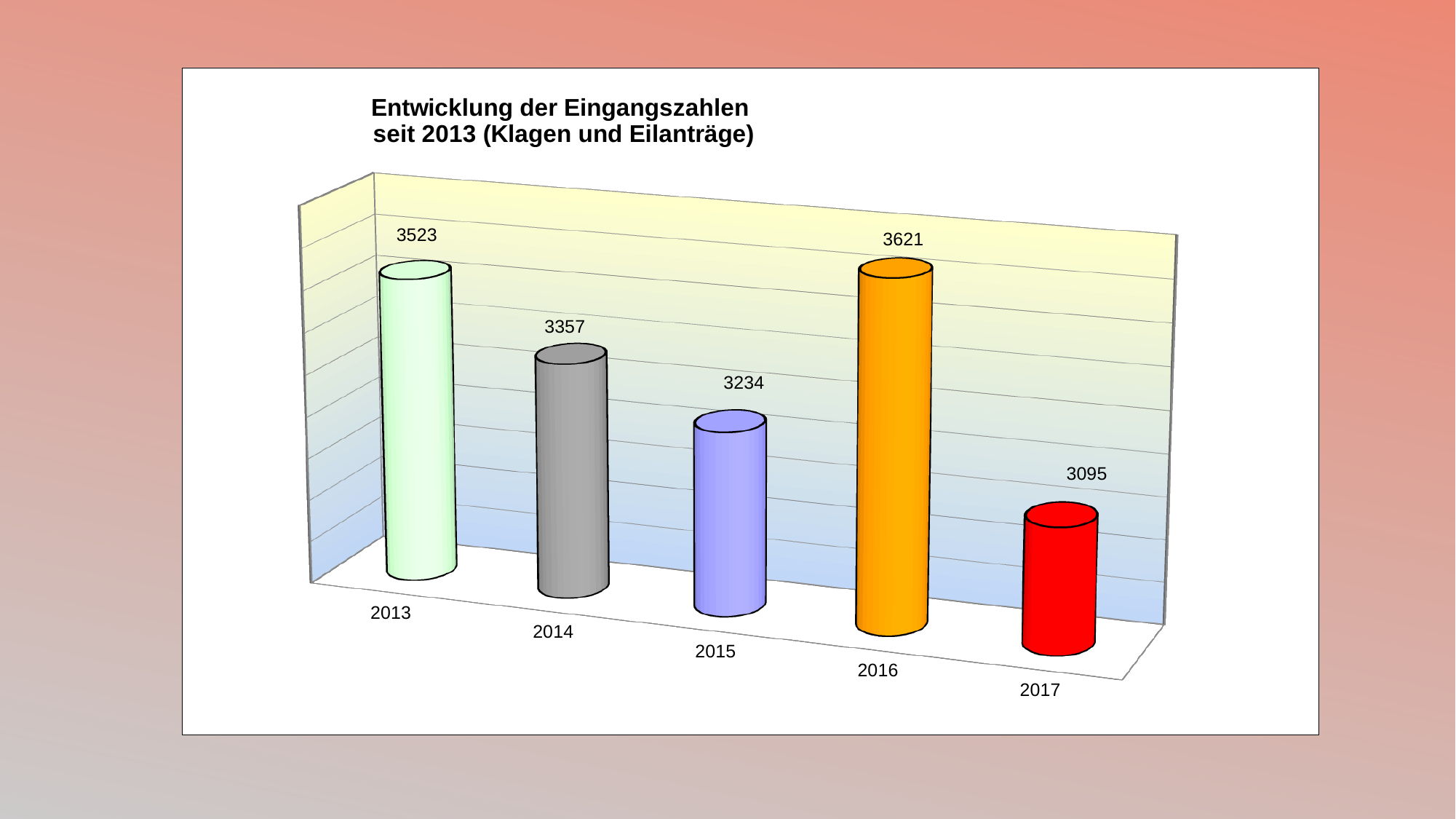
What is the difference between the values for 2013 and 2014? 166 What kind of chart is this? bar chart Which year has the highest value? 2016 What is the value for 2017? 3095 What is the title of the chart? Entwicklung der Eingangszahlen seit 2013 (Klagen und Eilanträge) How many years are shown on the chart? 5 Which year has the lowest value? 2017 Does the value rise or fall from 2016 to 2017? fall What is the value for 2013? 3523 What is the difference between the values for 2016 and 2017? 526 What is the value for 2016? 3621 Which is larger, the value for 2014 or the value for 2015? 2014